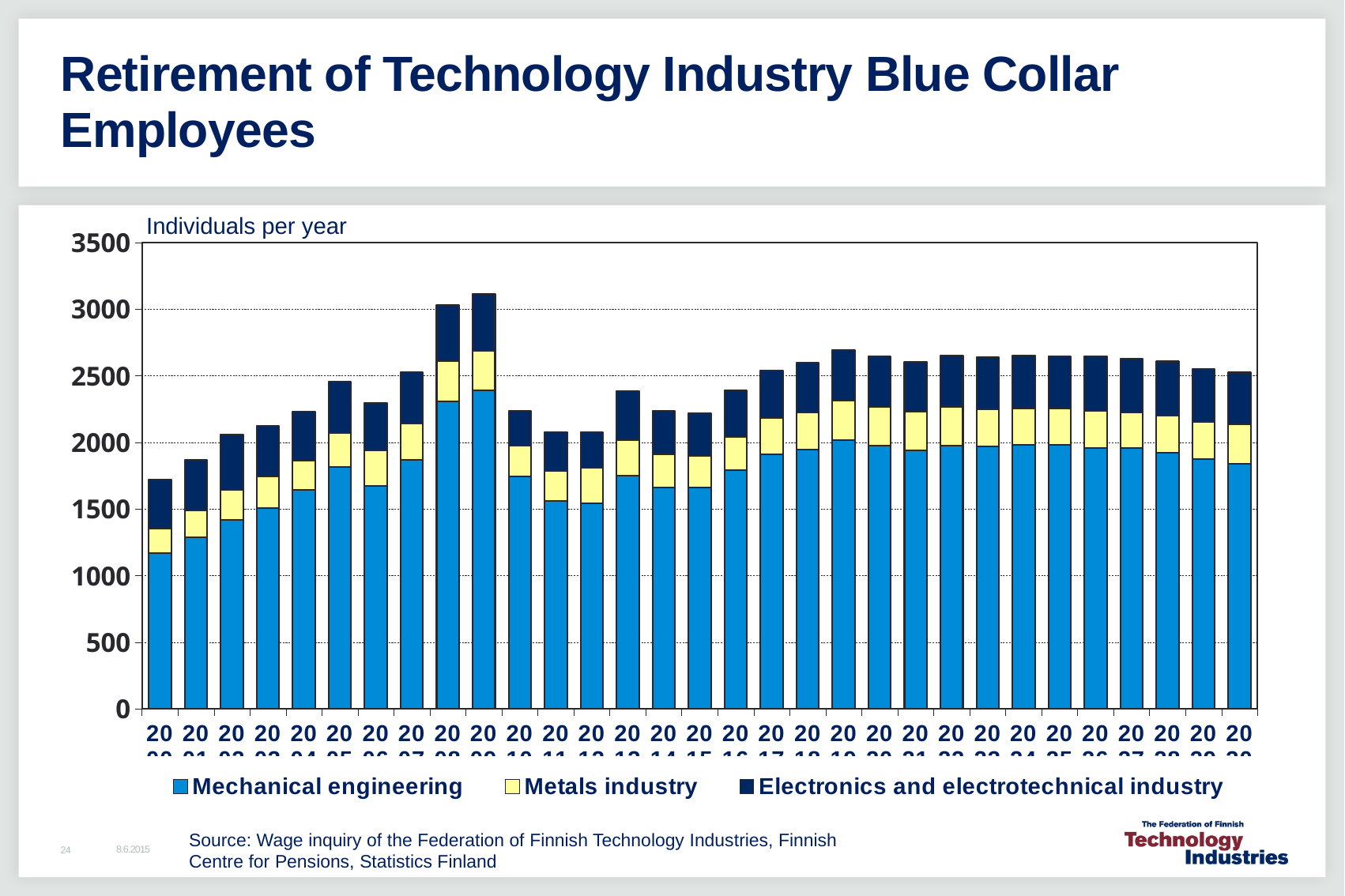
Is the total of the rightmost bar greater or less than 2000? greater Which bar has the lowest total in the chart? The first (leftmost) bar Is the total of the tallest bar greater or less than 3000? greater Which bar has the highest total in the chart? The tenth bar from the left How many series does the legend list? 3 Which has the larger total, the leftmost bar or the rightmost bar? The rightmost bar What label is shown above the vertical axis of the chart? Individuals per year How many stacked bars are plotted in the chart? 31 Is the Mechanical engineering value in the tallest bar greater or less than 2000? greater What kind of chart is shown on the slide? Stacked bar chart Which series forms the bottom segment of each stacked bar? Mechanical engineering